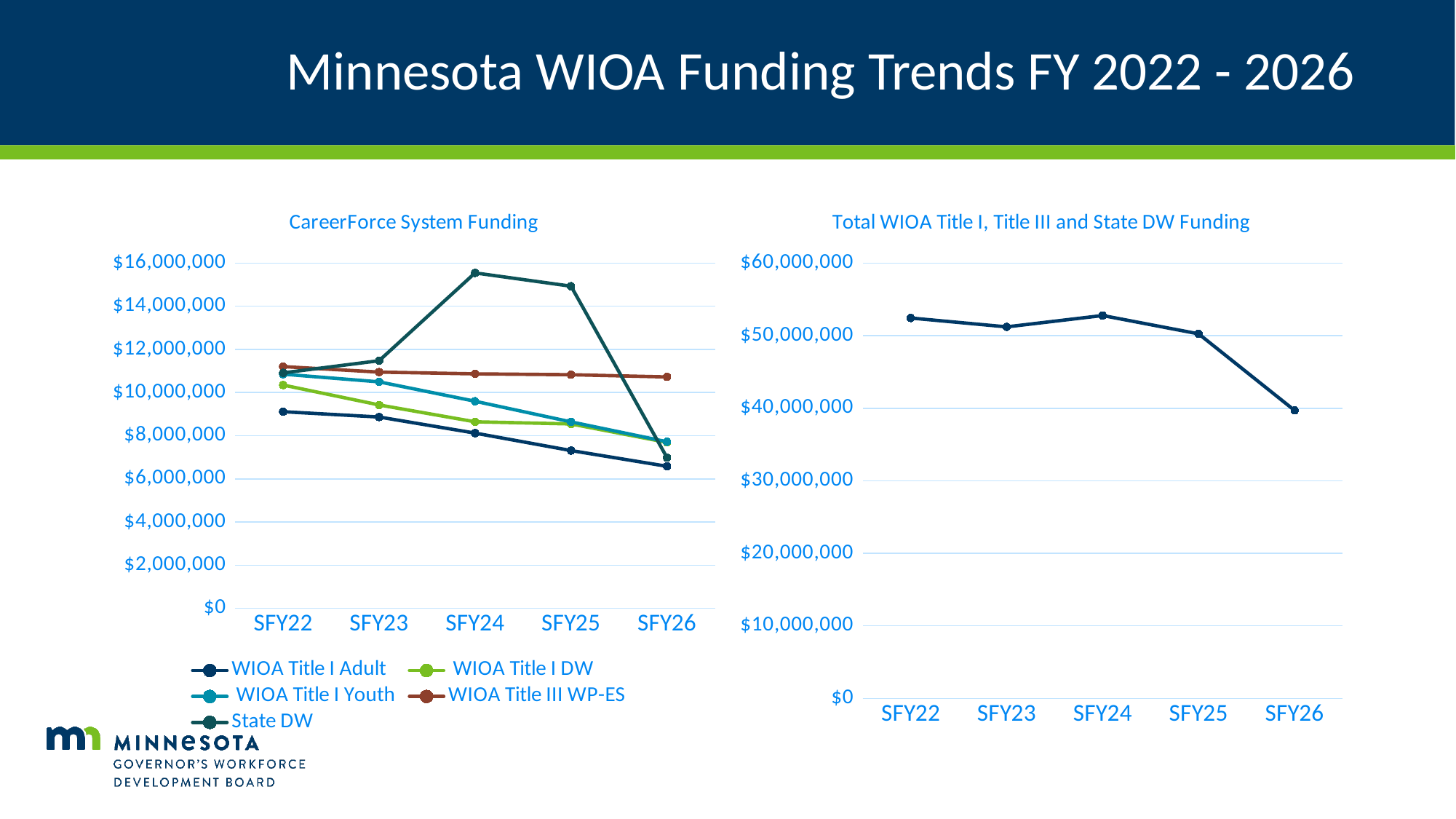
In the CareerForce System Funding chart, in which year is State DW funding highest? SFY24 In the CareerForce System Funding chart, does WIOA Title I Adult funding rise or fall from SFY22 to SFY26? fall In the CareerForce System Funding chart, is the WIOA Title I Adult value for SFY26 greater or less than $8,000,000? less How many fiscal years are shown on the x axis of the Total WIOA Title I, Title III and State DW Funding chart? 5 In the Total WIOA Title I, Title III and State DW Funding chart, which year has the lowest value? SFY26 What kind of chart is the CareerForce System Funding chart? line chart In the CareerForce System Funding chart, which is larger in SFY24: State DW or WIOA Title I Adult? State DW In the CareerForce System Funding chart, is the State DW value for SFY24 greater or less than $14,000,000? greater In the CareerForce System Funding chart, in which year is WIOA Title I Adult funding lowest? SFY26 How many series does the legend of the CareerForce System Funding chart list? 5 In the CareerForce System Funding chart, is the WIOA Title III WP-ES value for SFY22 greater or less than $10,000,000? greater